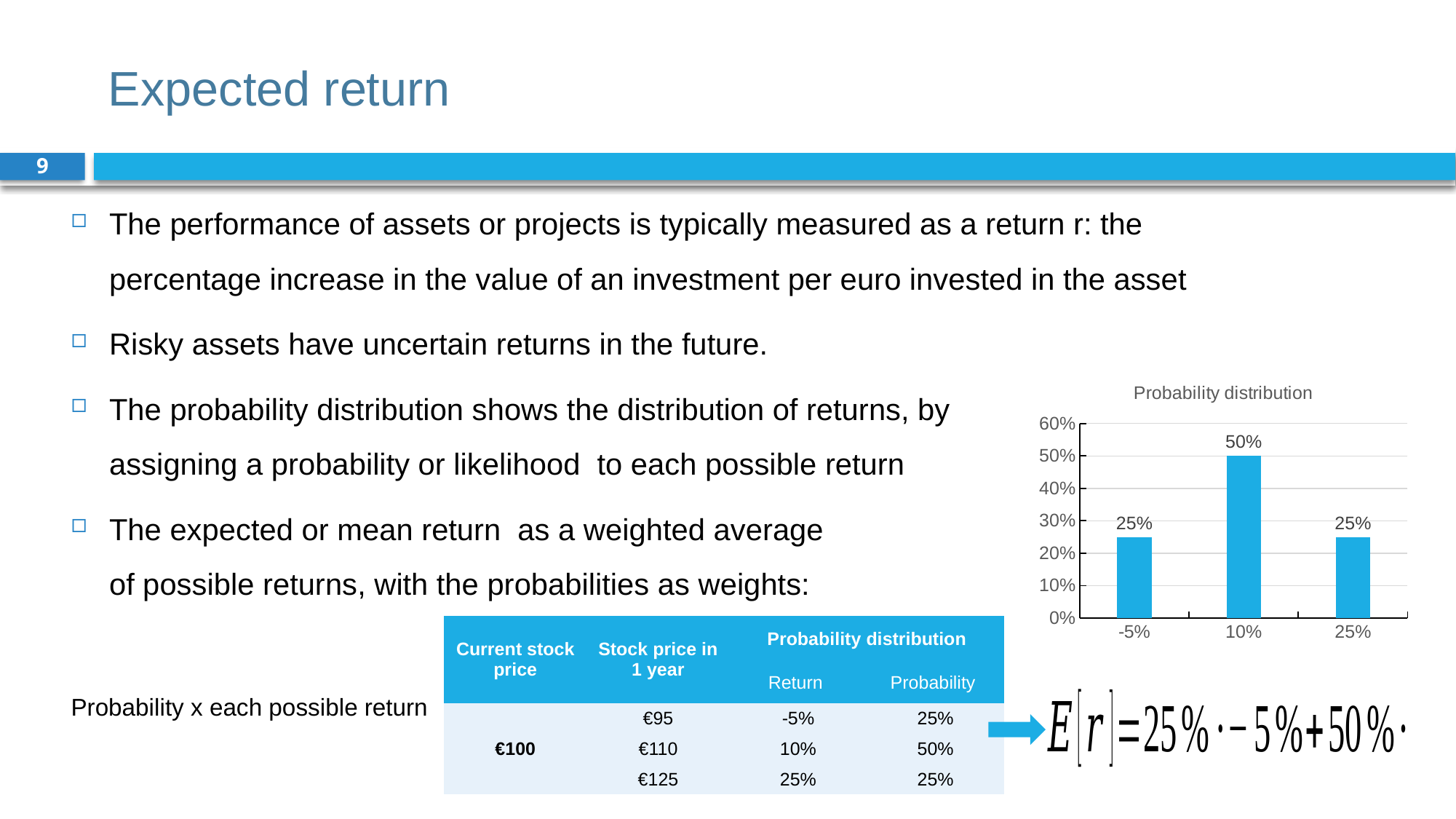
What is the title of the chart on the slide? Probability distribution What is the probability shown for the -5% return in the chart? 25% Which is larger in the chart: the probability for the 10% return or the probability for the 25% return? 10% return Is the probability for the 25% return greater or less than 30%? less How many bars are plotted in the Probability distribution chart? 3 Is the probability for the 10% return greater or less than 40%? greater What type of chart is shown on the slide? bar chart What is the probability shown for the 10% return in the chart? 50% What is the difference between the probability for the 10% return and the probability for the -5% return? 25% What is the highest value shown on the vertical axis of the chart? 60% Which return category has the highest probability in the chart? 10% What is the probability shown for the 25% return in the chart? 25%